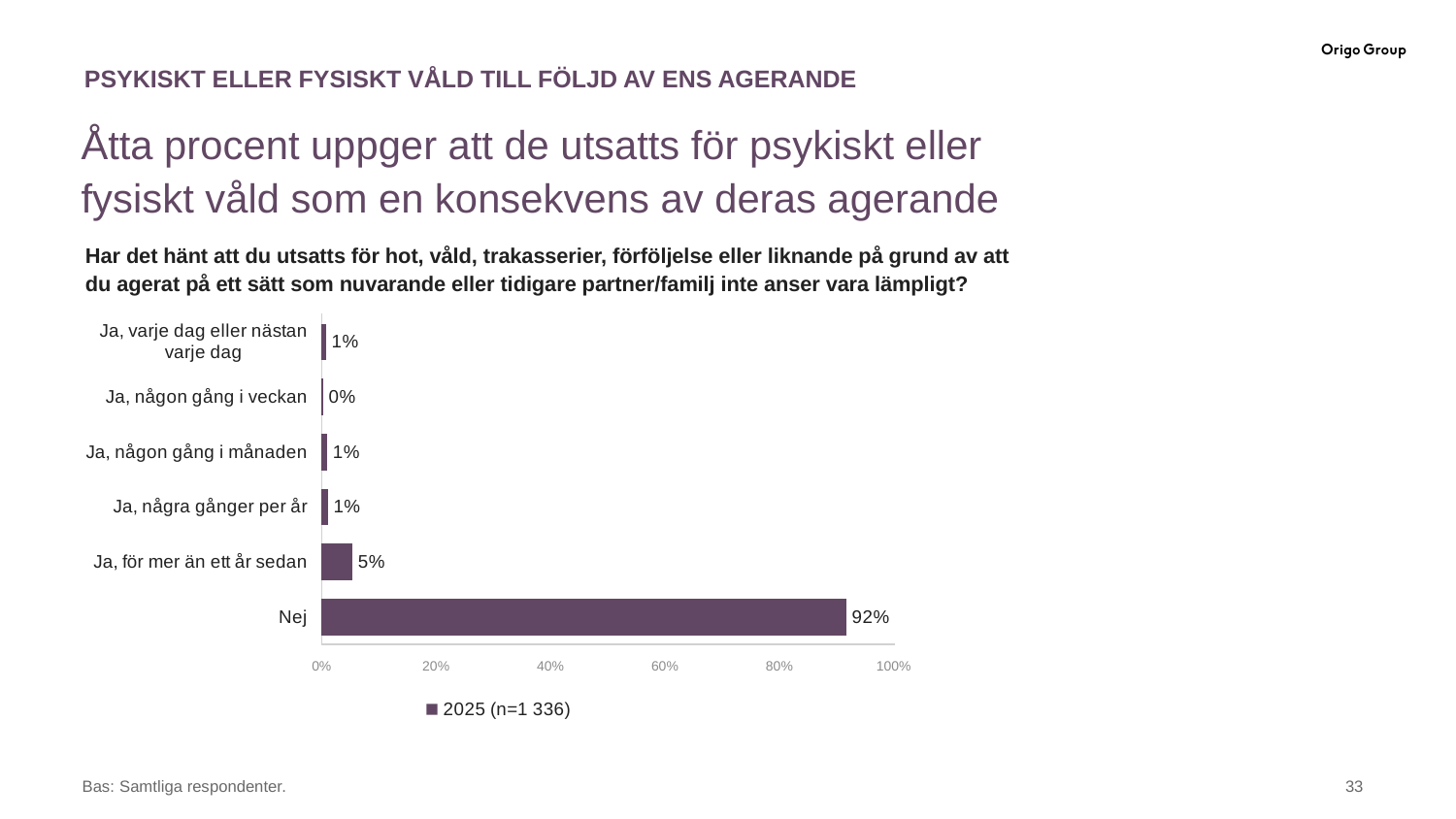
Which is larger, the value for "Ja, för mer än ett år sedan" or the value for "Ja, några gånger per år"? Ja, för mer än ett år sedan What kind of chart is shown on the slide? Bar chart What is the value for "Ja, för mer än ett år sedan"? 5% What is the value for "Nej"? 92% What is the value for "Ja, varje dag eller nästan varje dag"? 1% What series does the legend list? 2025 (n=1 336) Is the value for "Nej" greater or less than 80%? greater Which category has the lowest value? Ja, någon gång i veckan Which category has the highest value? Nej What is the difference between the values for "Nej" and "Ja, för mer än ett år sedan"? 87% How many categories are shown in the chart? 6 What is the value for "Ja, någon gång i veckan"? 0%